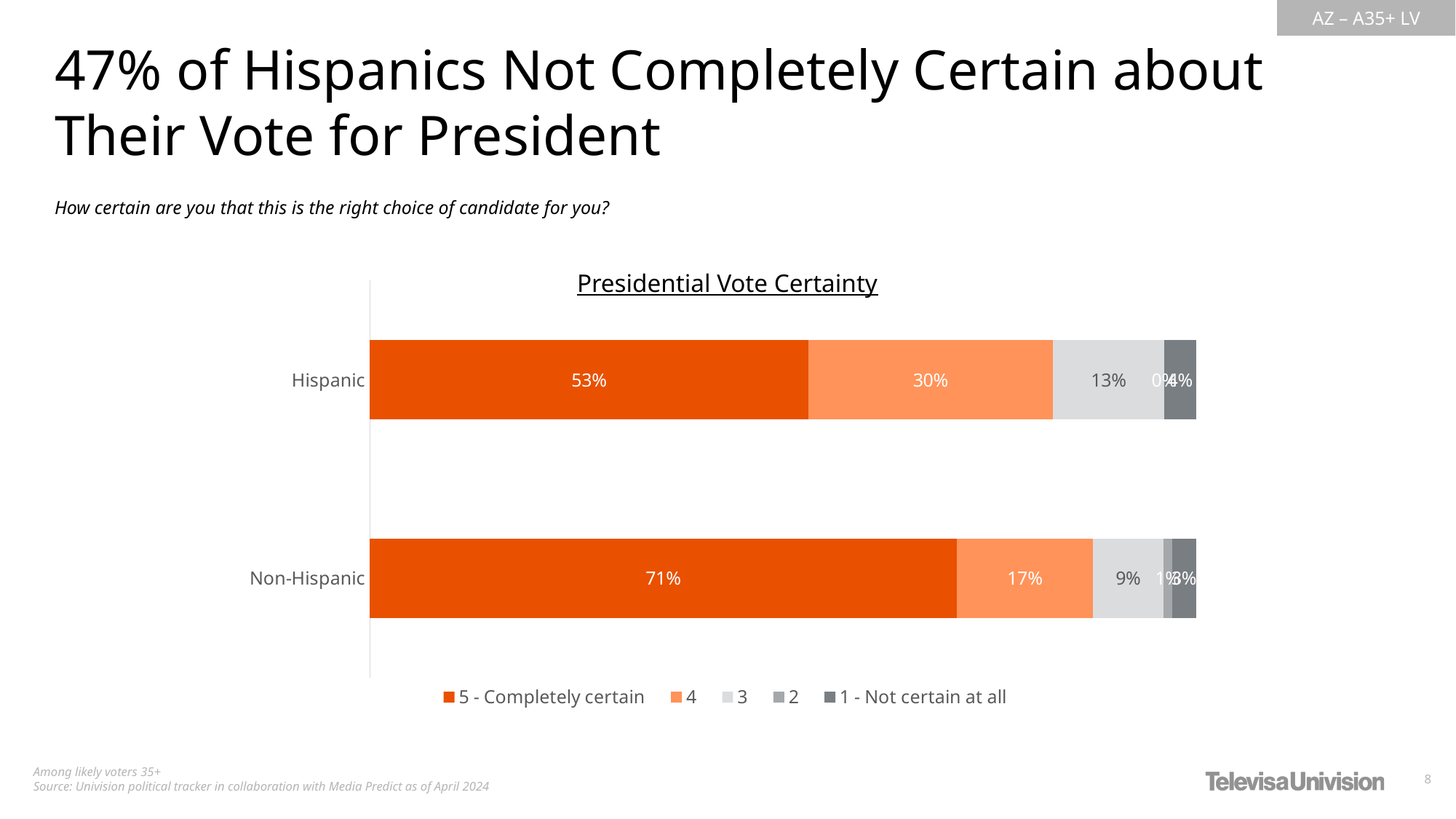
What percentage of Non-Hispanic likely voters gave a certainty rating of 3? 9% How many groups (categories) are plotted on the chart? 2 Which legend entry is shown in the darkest orange colour? 5 - Completely certain What kind of chart is shown under the title 'Presidential Vote Certainty'? Stacked bar chart What percentage of Non-Hispanic likely voters are '5 - Completely certain' about their presidential vote? 71% What percentage of Hispanic likely voters gave a certainty rating of 3? 13% Which group has the larger share of '5 - Completely certain' voters, Hispanic or Non-Hispanic? Non-Hispanic What is the difference between the Hispanic and Non-Hispanic shares of voters rating their certainty as 4? 13 percentage points What percentage of Hispanic likely voters are '5 - Completely certain' about their presidential vote? 53% What percentage of Hispanic likely voters gave a certainty rating of 4? 30% What is the difference between the Non-Hispanic and Hispanic shares of '5 - Completely certain' voters? 18 percentage points How many series does the legend list? 5